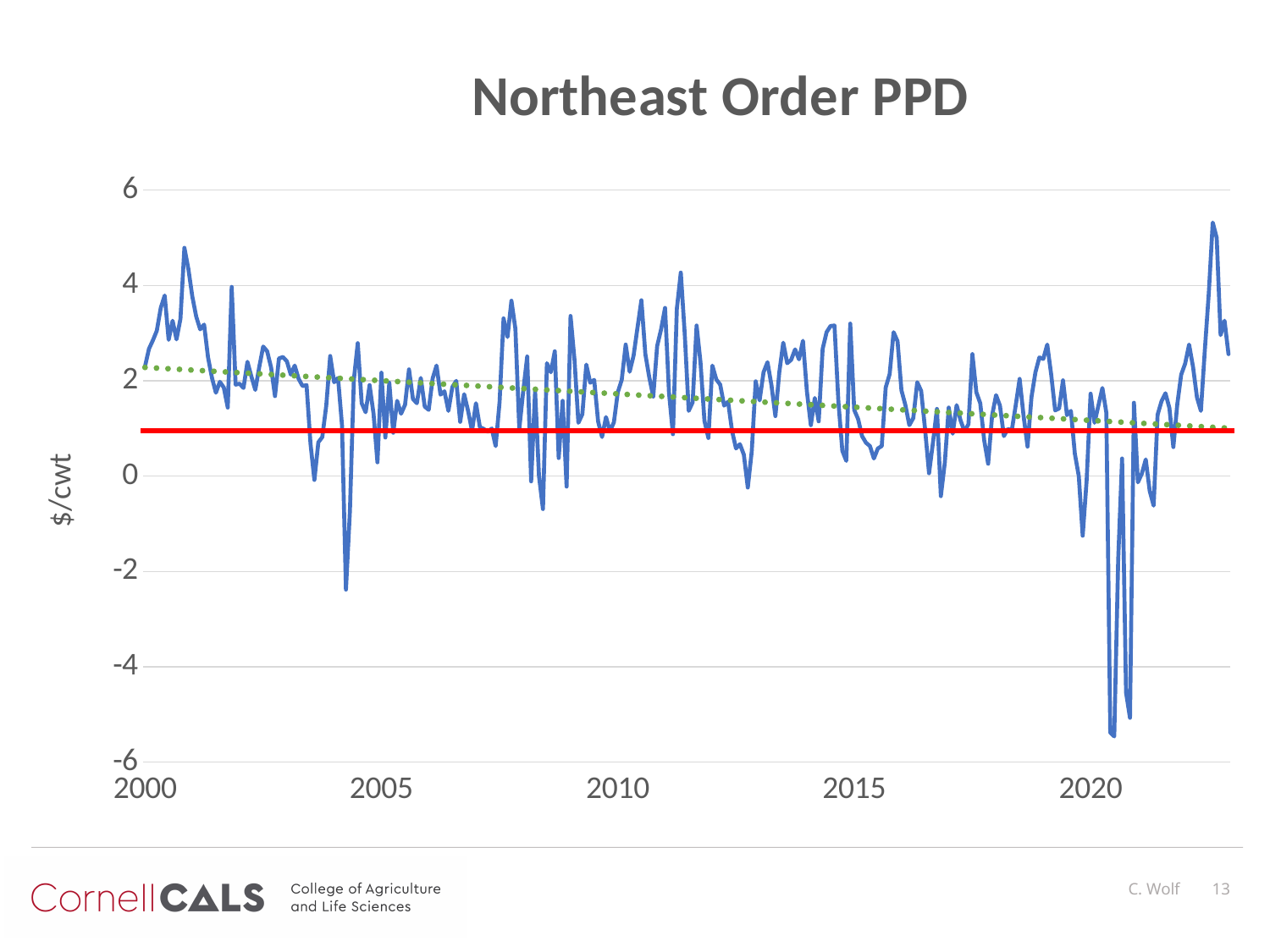
What is the lowest value shown on the vertical axis? -6 What is the label on the vertical axis of the chart? $/cwt What is the title of the chart? Northeast Order PPD Does the green dotted trend line rise or fall from 2000 to the end of the series? Fall Is the lowest value of the blue line, reached around 2020, greater or less than -4? less Is the highest value of the blue line, reached after 2020, greater or less than 4? greater What is the highest value shown on the vertical axis? 6 Is the value of the blue line at its dip around 2004 greater or less than 0? less What kind of chart is shown on the slide? Line chart